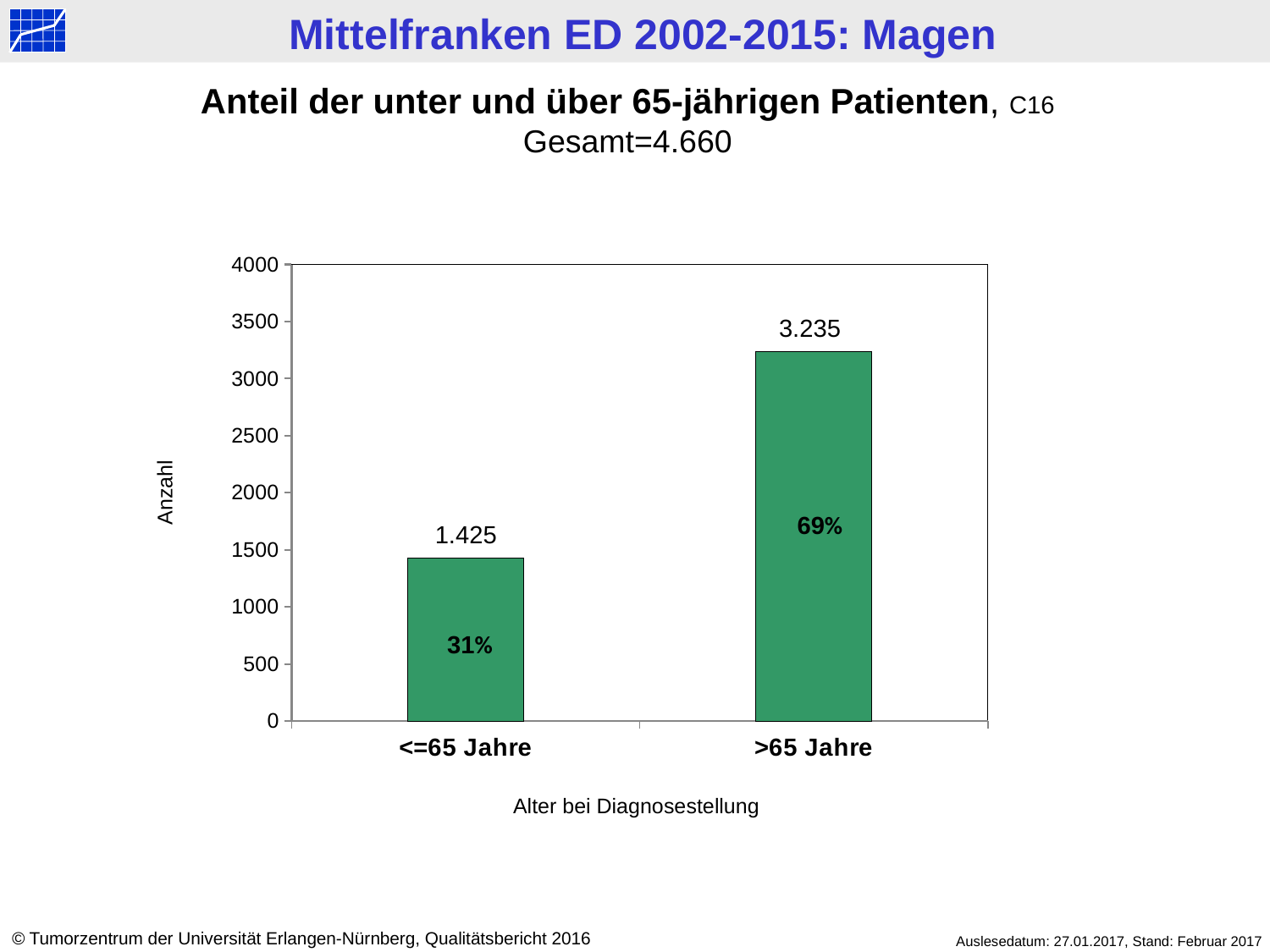
What is the label of the y axis? Anzahl What is the value for the ">65 Jahre" category? 3.235 Which category has the highest value? >65 Jahre What kind of chart is shown on the slide? bar chart What percentage is shown on the ">65 Jahre" bar? 69% Is the value for ">65 Jahre" greater or less than 3000? greater Which category has the lowest value? <=65 Jahre What is the difference between the values for ">65 Jahre" and "<=65 Jahre"? 1.810 Which is larger, the value for "<=65 Jahre" or for ">65 Jahre"? >65 Jahre What is the value for the "<=65 Jahre" category? 1.425 How many categories are shown on the x axis? 2 What percentage is shown on the "<=65 Jahre" bar? 31%